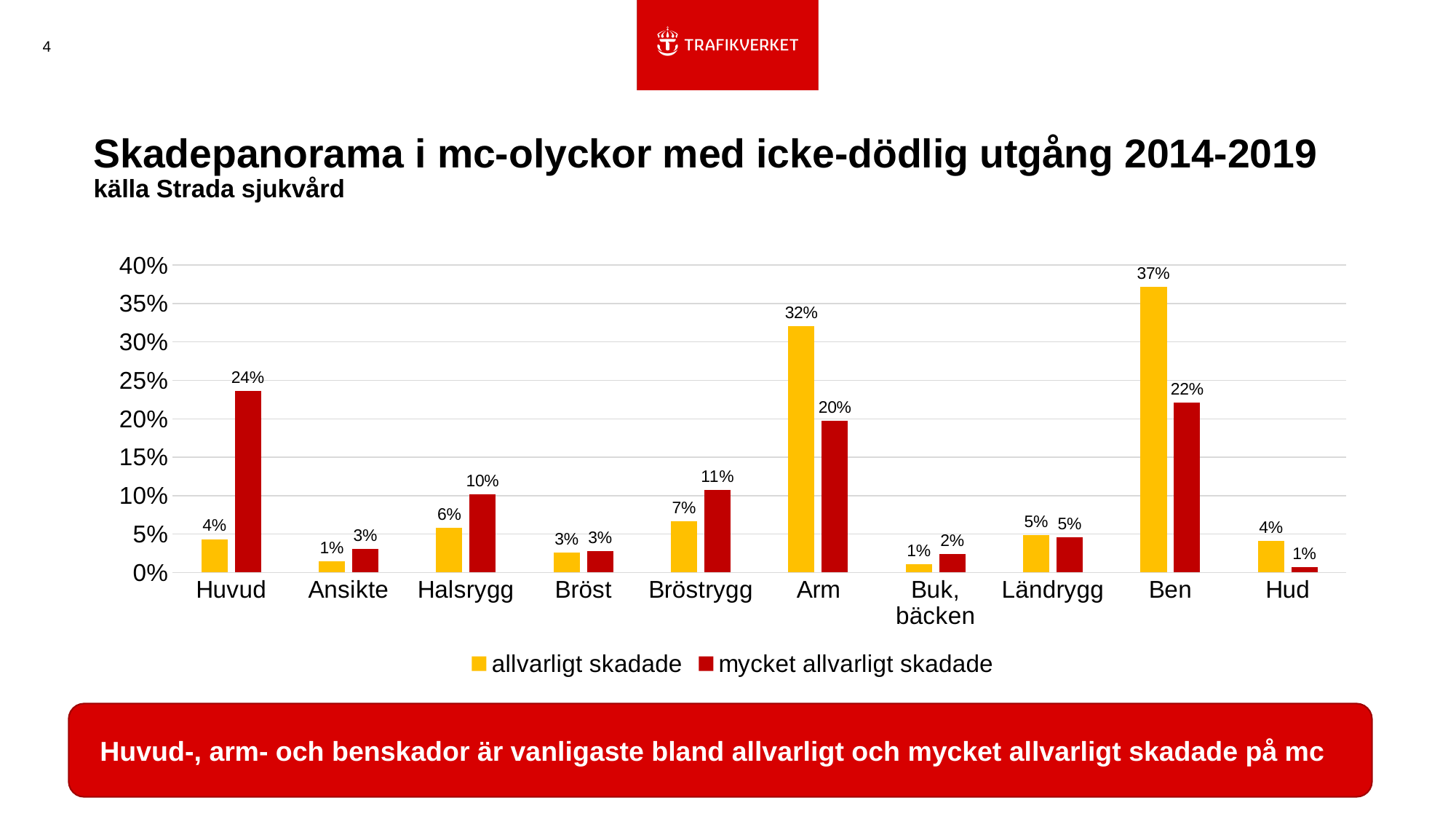
What is the difference between the 'allvarligt skadade' values for Ben and Arm? 5% Which category has the highest value for 'mycket allvarligt skadade'? Huvud How many series does the legend list? 2 What is the value for 'allvarligt skadade' for Arm? 32% Which category has the lowest value for 'mycket allvarligt skadade'? Hud Is the 'allvarligt skadade' value for Ben greater or less than 35%? greater What is the value for 'mycket allvarligt skadade' for Huvud? 24% Which is larger for Halsrygg: 'allvarligt skadade' or 'mycket allvarligt skadade'? mycket allvarligt skadade How many categories are shown on the x axis? 10 What kind of chart is shown on the slide? bar chart What colour represents 'mycket allvarligt skadade' in the chart? red What is the value for 'allvarligt skadade' for Ben? 37%